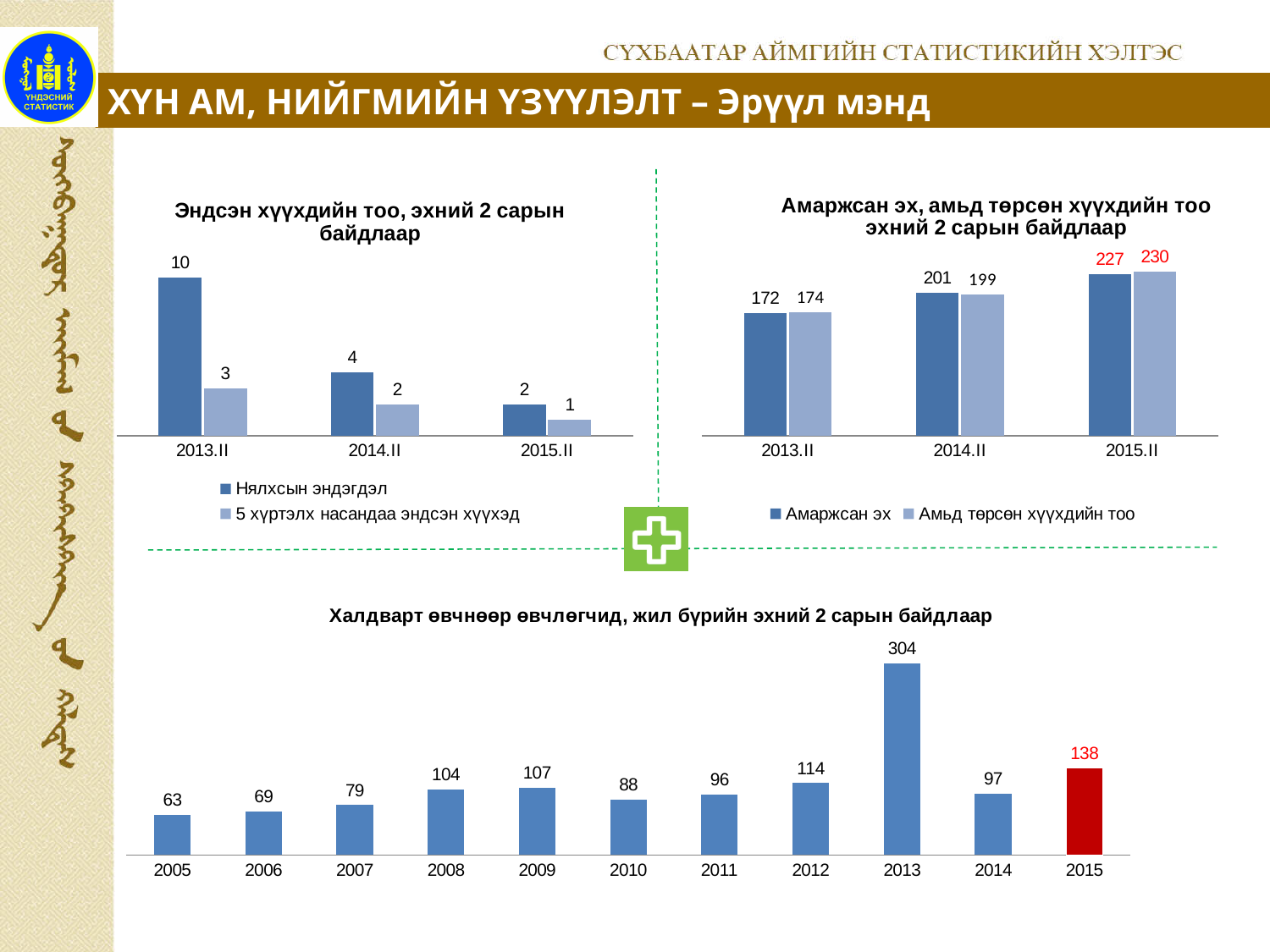
In the top-right chart (Амаржсан эх, амьд төрсөн хүүхдийн тоо), what is the value of Амаржсан эх for 2014.II? 201 In the top-left chart (Эндсэн хүүхдийн тоо), what is the value of 5 хүртэлх насандаа эндсэн хүүхэд for 2015.II? 1 In the top-right chart (Амаржсан эх, амьд төрсөн хүүхдийн тоо), what is the value of Амьд төрсөн хүүхдийн тоо for 2015.II? 230 In the bottom chart (Халдварт өвчнөөр өвчлөгчид), what is the value for 2015? 138 In the top-right chart (Амаржсан эх, амьд төрсөн хүүхдийн тоо), what is the difference between Амьд төрсөн хүүхдийн тоо in 2015.II and 2013.II? 56 In the bottom chart (Халдварт өвчнөөр өвчлөгчид), which year has the lowest value? 2005 In the bottom chart (Халдварт өвчнөөр өвчлөгчид), which year has the highest value? 2013 In the top-left chart (Эндсэн хүүхдийн тоо), what is the value of Нялхсын эндэгдэл for 2013.II? 10 In the top-right chart (Амаржсан эх, амьд төрсөн хүүхдийн тоо), how many series does the legend list? 2 In the top-left chart (Эндсэн хүүхдийн тоо), does Нялхсын эндэгдэл rise or fall from 2013.II to 2015.II? fall In the bottom chart (Халдварт өвчнөөр өвчлөгчид), how many years are shown on the x axis? 11 In the top-left chart (Эндсэн хүүхдийн тоо), what is the difference between Нялхсын эндэгдэл and 5 хүртэлх насандаа эндсэн хүүхэд in 2013.II? 7